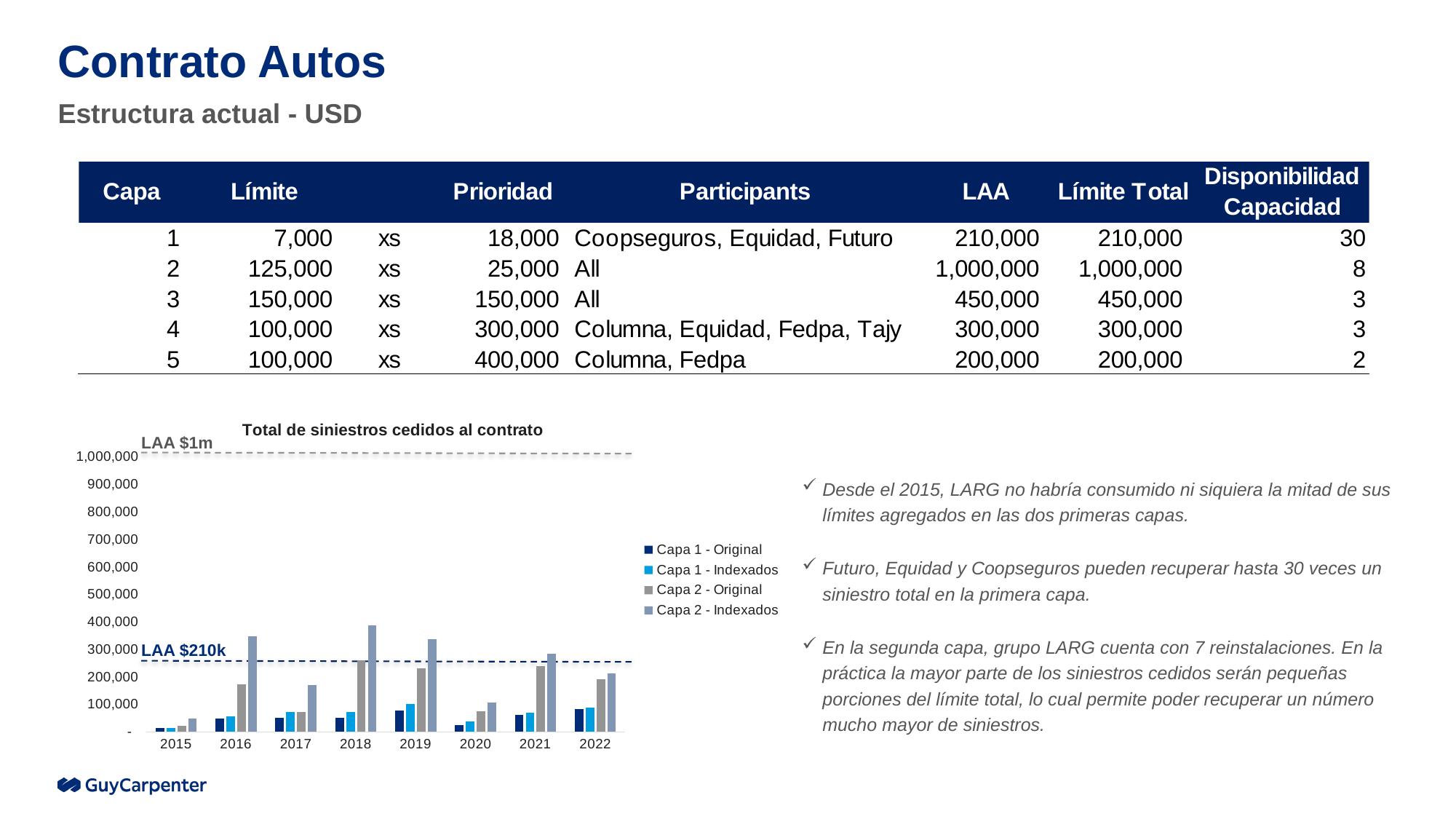
Is the value for Capa 1 - Original in 2015 greater or less than 100,000? less Is the value for Capa 2 - Indexados in 2017 greater or less than 200,000? less Which is larger: Capa 1 - Original in 2019 or Capa 1 - Original in 2020? 2019 What is the title of the chart on the slide? Total de siniestros cedidos al contrato How many series does the chart's legend list? 4 What label is shown on the upper dashed horizontal line in the chart? LAA $1m Is the value for Capa 2 - Indexados in 2018 greater or less than 300,000? greater Which year has the lowest value for Capa 2 - Indexados? 2015 What kind of chart is shown on the slide? bar chart How many years are shown along the x axis of the chart? 8 Which year has the highest value for Capa 2 - Indexados? 2018 Which is larger: Capa 2 - Indexados in 2018 or Capa 2 - Indexados in 2016? 2018